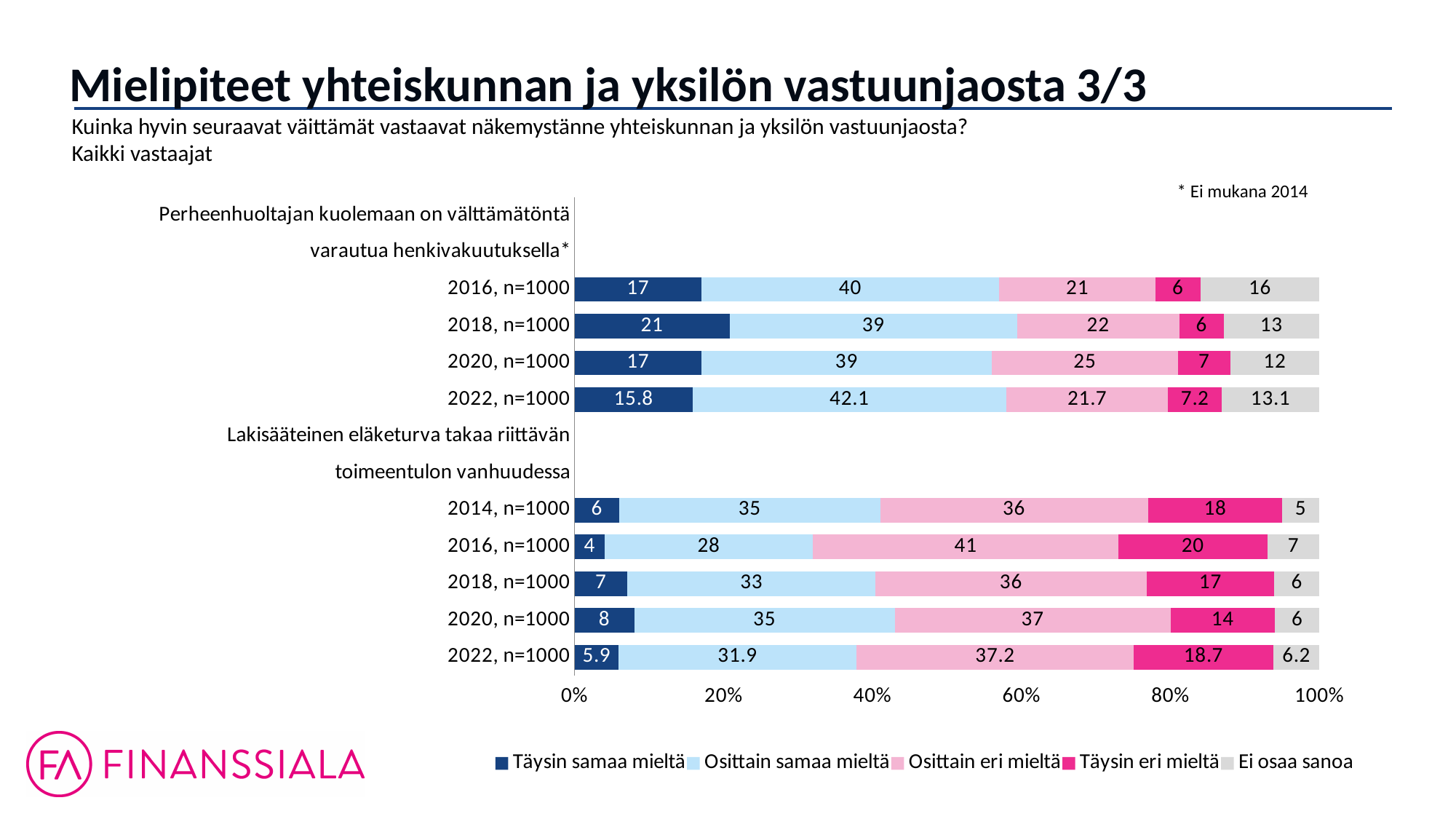
What kind of chart is shown on the slide? Stacked bar chart What is the value of "Ei osaa sanoa" for the 2022, n=1000 bar under "Lakisääteinen eläketurva takaa riittävän toimeentulon vanhuudessa"? 6.2 What does the footnote marked with an asterisk on the chart say? Ei mukana 2014 How many stacked bars are plotted in the chart in total? 9 Under "Perheenhuoltajan kuolemaan on välttämätöntä varautua henkivakuutuksella", which year has the larger "Osittain eri mieltä" value, 2018 or 2020? 2020, n=1000 How many series does the legend list? 5 Among the bars under "Lakisääteinen eläketurva takaa riittävän toimeentulon vanhuudessa", which year has the lowest "Täysin samaa mieltä" value? 2016, n=1000 What is the value of "Osittain eri mieltä" for the 2014, n=1000 bar under "Lakisääteinen eläketurva takaa riittävän toimeentulon vanhuudessa"? 36 What is the value of "Täysin samaa mieltä" for the 2016, n=1000 bar under "Perheenhuoltajan kuolemaan on välttämätöntä varautua henkivakuutuksella"? 17 Among the bars under "Lakisääteinen eläketurva takaa riittävän toimeentulon vanhuudessa", which year has the highest "Täysin eri mieltä" value? 2016, n=1000 Under "Perheenhuoltajan kuolemaan on välttämätöntä varautua henkivakuutuksella", what is the difference between the "Osittain samaa mieltä" values for 2022 and 2016? 2.1 What is the total of the 2016, n=1000 stacked bar under "Perheenhuoltajan kuolemaan on välttämätöntä varautua henkivakuutuksella"? 100